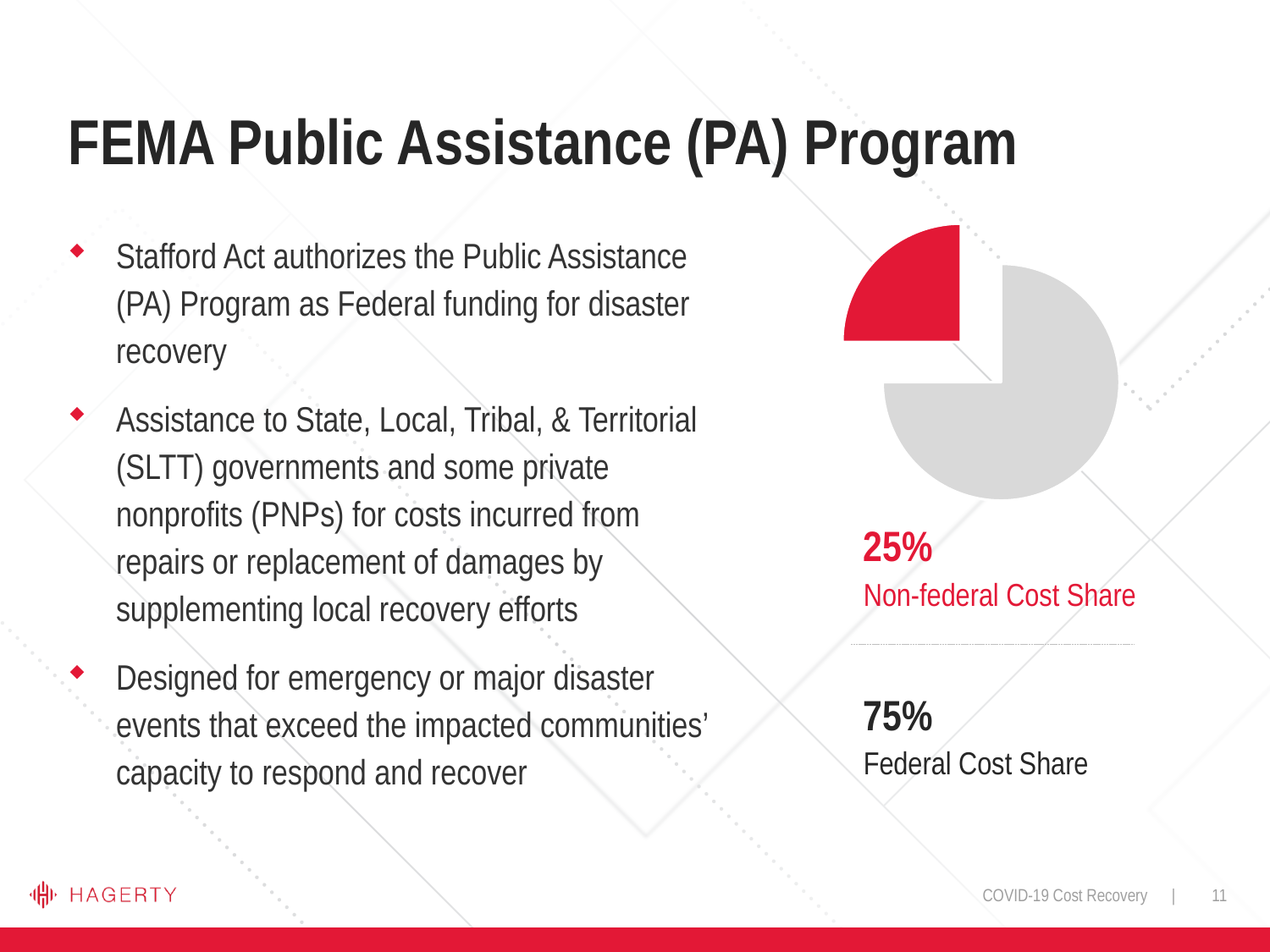
What is the difference between the Federal Cost Share and the Non-federal Cost Share? 50% Is the Federal Cost Share greater or less than 50%? greater Which slice of the pie chart is the largest? Federal Cost Share What is the total of the two cost shares shown in the pie chart? 100% What share of the pie chart is the Federal Cost Share? 75% How many slices does the pie chart have? 2 What kind of chart is shown on the slide? pie chart Which slice of the pie chart is the smallest? Non-federal Cost Share What colour is the Non-federal Cost Share slice in the pie chart? red What share of the pie chart is the Non-federal Cost Share? 25% What colour is the Federal Cost Share slice in the pie chart? grey Which slice of the pie chart is larger, Federal Cost Share or Non-federal Cost Share? Federal Cost Share